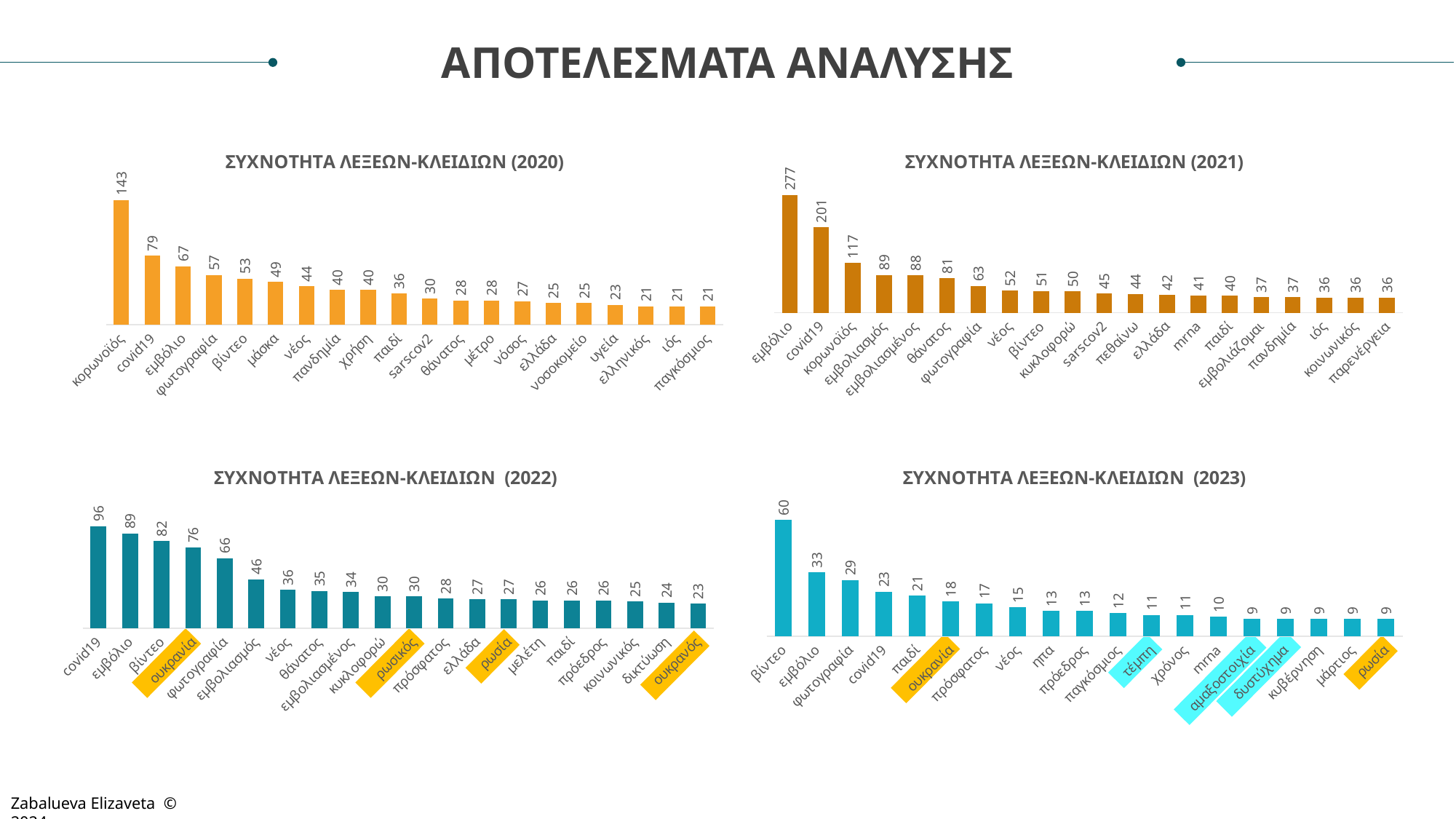
In the chart titled ΣΥΧΝΟΤΗΤΑ ΛΕΞΕΩΝ-ΚΛΕΙΔΙΩΝ (2021), what is the difference between the values for εμβόλιο and covid19? 76 In the chart titled ΣΥΧΝΟΤΗΤΑ ΛΕΞΕΩΝ-ΚΛΕΙΔΙΩΝ (2020), what is the value for κορωνοϊός? 143 In the chart titled ΣΥΧΝΟΤΗΤΑ ΛΕΞΕΩΝ-ΚΛΕΙΔΙΩΝ (2023), which keyword has the highest value? βίντεο In the chart titled ΣΥΧΝΟΤΗΤΑ ΛΕΞΕΩΝ-ΚΛΕΙΔΙΩΝ (2023), what is the value for τέμπη? 11 In the chart titled ΣΥΧΝΟΤΗΤΑ ΛΕΞΕΩΝ-ΚΛΕΙΔΙΩΝ (2021), which keyword has the highest value? εμβόλιο In the chart titled ΣΥΧΝΟΤΗΤΑ ΛΕΞΕΩΝ-ΚΛΕΙΔΙΩΝ (2023), how many keywords are plotted? 19 In the chart titled ΣΥΧΝΟΤΗΤΑ ΛΕΞΕΩΝ-ΚΛΕΙΔΙΩΝ (2022), what is the value for ουκρανία? 76 In the chart titled ΣΥΧΝΟΤΗΤΑ ΛΕΞΕΩΝ-ΚΛΕΙΔΙΩΝ (2021), what is the value for covid19? 201 In the chart titled ΣΥΧΝΟΤΗΤΑ ΛΕΞΕΩΝ-ΚΛΕΙΔΙΩΝ (2020), do the values rise or fall from left to right along the x axis? Fall In the chart titled ΣΥΧΝΟΤΗΤΑ ΛΕΞΕΩΝ-ΚΛΕΙΔΙΩΝ (2020), how many keywords are plotted? 20 What kind of chart is the chart titled ΣΥΧΝΟΤΗΤΑ ΛΕΞΕΩΝ-ΚΛΕΙΔΙΩΝ (2022)? Bar chart In the chart titled ΣΥΧΝΟΤΗΤΑ ΛΕΞΕΩΝ-ΚΛΕΙΔΙΩΝ (2022), which is larger, the value for βίντεο or the value for φωτογραφία? βίντεο